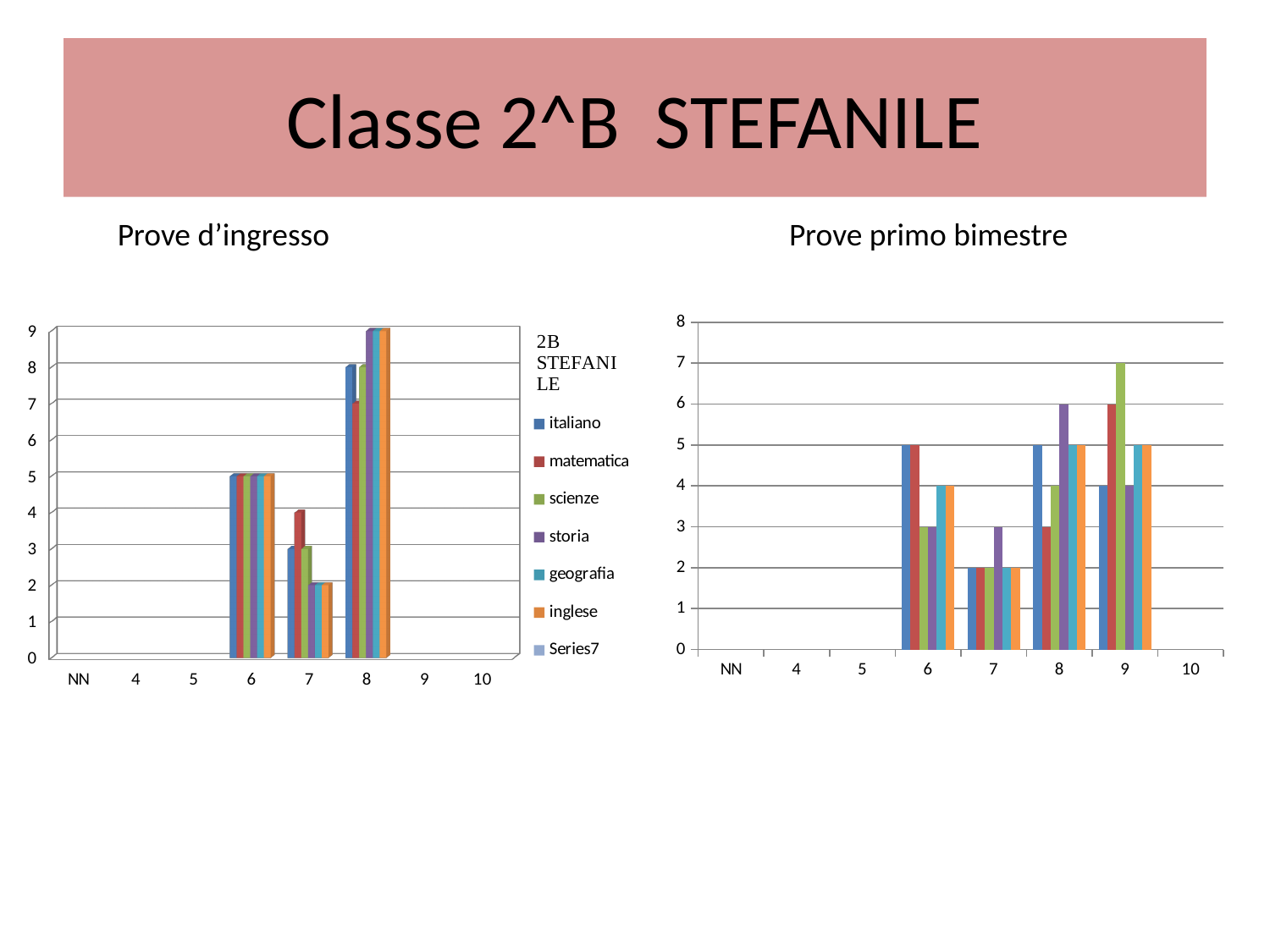
In the 'Prove d'ingresso' chart, what is the value for italiano at category 6? 5 In the 'Prove d'ingresso' chart, which series has the highest value at category 7? matematica In the 'Prove d'ingresso' chart, what is the value for matematica at category 7? 4 In the 'Prove primo bimestre' chart, which category has the tallest bar overall? 9 How many entries does the legend of the 'Prove d'ingresso' chart list? 7 In the 'Prove d'ingresso' chart, is the value for matematica at category 8 larger or smaller than the value for italiano at category 8? smaller In the 'Prove primo bimestre' chart, what value does the tallest bar at category 9 reach? 7 In the 'Prove primo bimestre' chart, what value does the tallest bar at category 8 reach? 6 In the 'Prove d'ingresso' chart, what is the value for storia at category 8? 9 How many categories are shown on the x axis of the 'Prove primo bimestre' chart? 8 What type of chart is the 'Prove d'ingresso' chart on the left? bar chart In the 'Prove d'ingresso' chart, which series has the lowest value at category 8? matematica